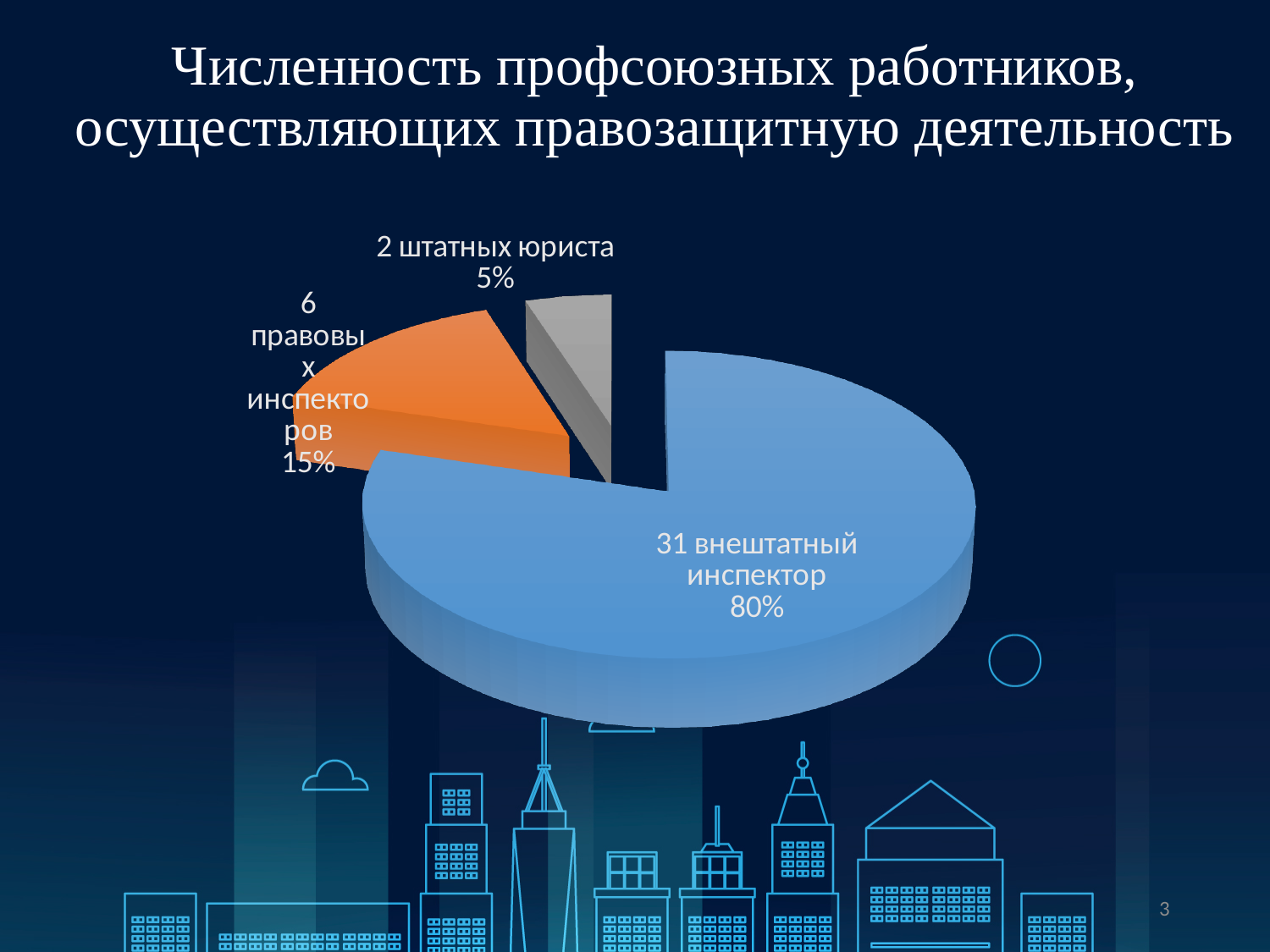
What share of the pie does the slice "штатных юриста" represent? 5% What is the title of the chart on the slide? Численность профсоюзных работников, осуществляющих правозащитную деятельность What is the difference in percentage points between the "внештатный инспектор" slice and the "правовых инспекторов" slice? 65% What kind of chart is shown on the slide? pie chart Which category has the largest slice of the pie? 31 внештатный инспектор How many slices does the pie chart have? 3 How many "штатных юриста" are shown in the chart label? 2 What share of the pie does the slice "правовых инспекторов" represent? 15% What share of the pie does the slice "внештатный инспектор" represent? 80% How many "внештатный инспектор" are shown in the chart label? 31 Which category has the smallest slice of the pie? 2 штатных юриста How many "правовых инспекторов" are shown in the chart label? 6